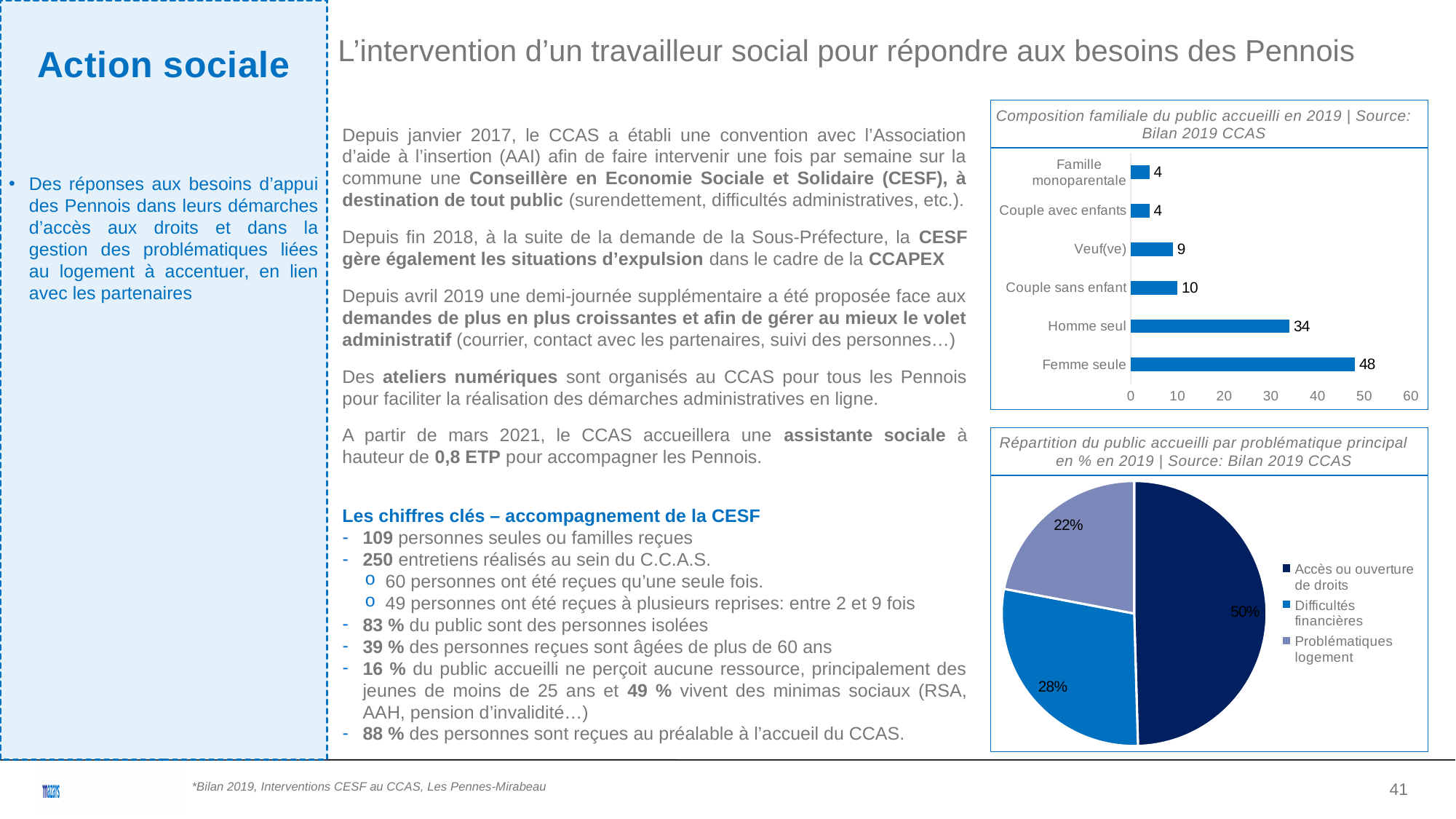
In the 'Composition familiale du public accueilli en 2019' chart, what is the value for Homme seul? 34 In the 'Composition familiale du public accueilli en 2019' chart, what is the value for Femme seule? 48 In the 'Composition familiale du public accueilli en 2019' chart, what is the value for Veuf(ve)? 9 In the 'Répartition du public accueilli par problématique principal' chart, what share is Problématiques logement? 22% What kind of chart is the 'Composition familiale du public accueilli en 2019' chart? Bar chart In the 'Composition familiale du public accueilli en 2019' chart, which category has the highest value? Femme seule In the 'Répartition du public accueilli par problématique principal' chart, which category has the largest share? Accès ou ouverture de droits How many categories are shown in the 'Composition familiale du public accueilli en 2019' chart? 6 In the 'Répartition du public accueilli par problématique principal' chart, what share is Difficultés financières? 28% In the 'Composition familiale du public accueilli en 2019' chart, which is larger: Couple sans enfant or Veuf(ve)? Couple sans enfant How many entries does the legend of the 'Répartition du public accueilli par problématique principal' chart list? 3 In the 'Composition familiale du public accueilli en 2019' chart, what is the difference between Femme seule and Homme seul? 14